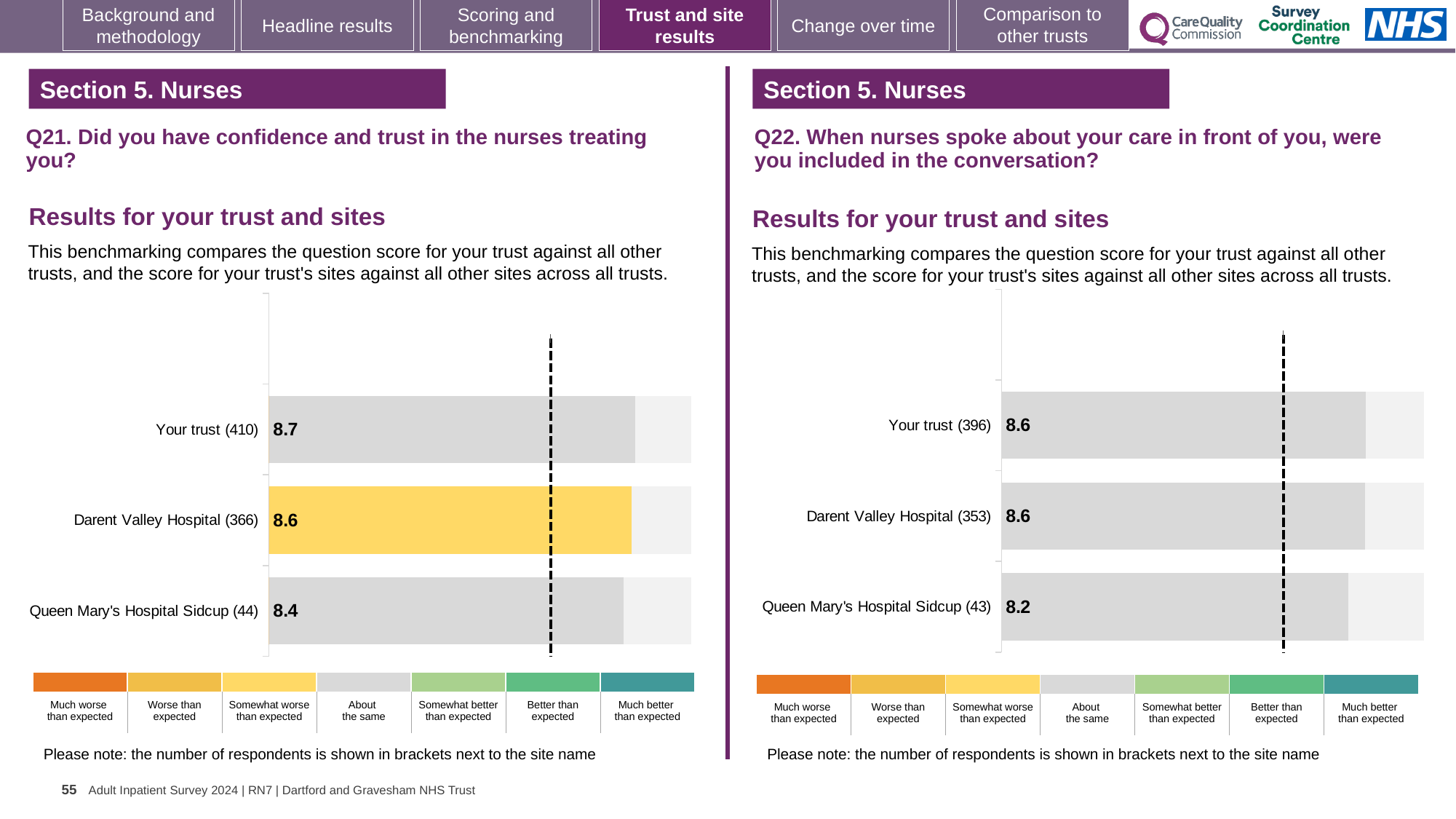
On the Q22 chart (right), what is the score for Your trust? 8.6 What kind of chart is the Q22 chart (right)? Bar chart On the Q21 chart (left), how many bars are plotted? 3 On the Q21 chart (left), what is the score for Queen Mary's Hospital Sidcup? 8.4 On the Q21 chart (left), what is the score for Your trust? 8.7 On the Q22 chart (right), what is the difference between the scores for Darent Valley Hospital and Queen Mary's Hospital Sidcup? 0.4 On the Q21 chart (left), what is the difference between the scores for Your trust and Queen Mary's Hospital Sidcup? 0.3 On the Q21 chart (left), what is the score for Darent Valley Hospital? 8.6 On the Q21 chart (left), which site or trust has the lowest score? Queen Mary's Hospital Sidcup On the Q22 chart (right), which site or trust has the lowest score? Queen Mary's Hospital Sidcup On the Q22 chart (right), what is the score for Queen Mary's Hospital Sidcup? 8.2 On the Q21 chart (left), which bar is coloured yellow? Darent Valley Hospital